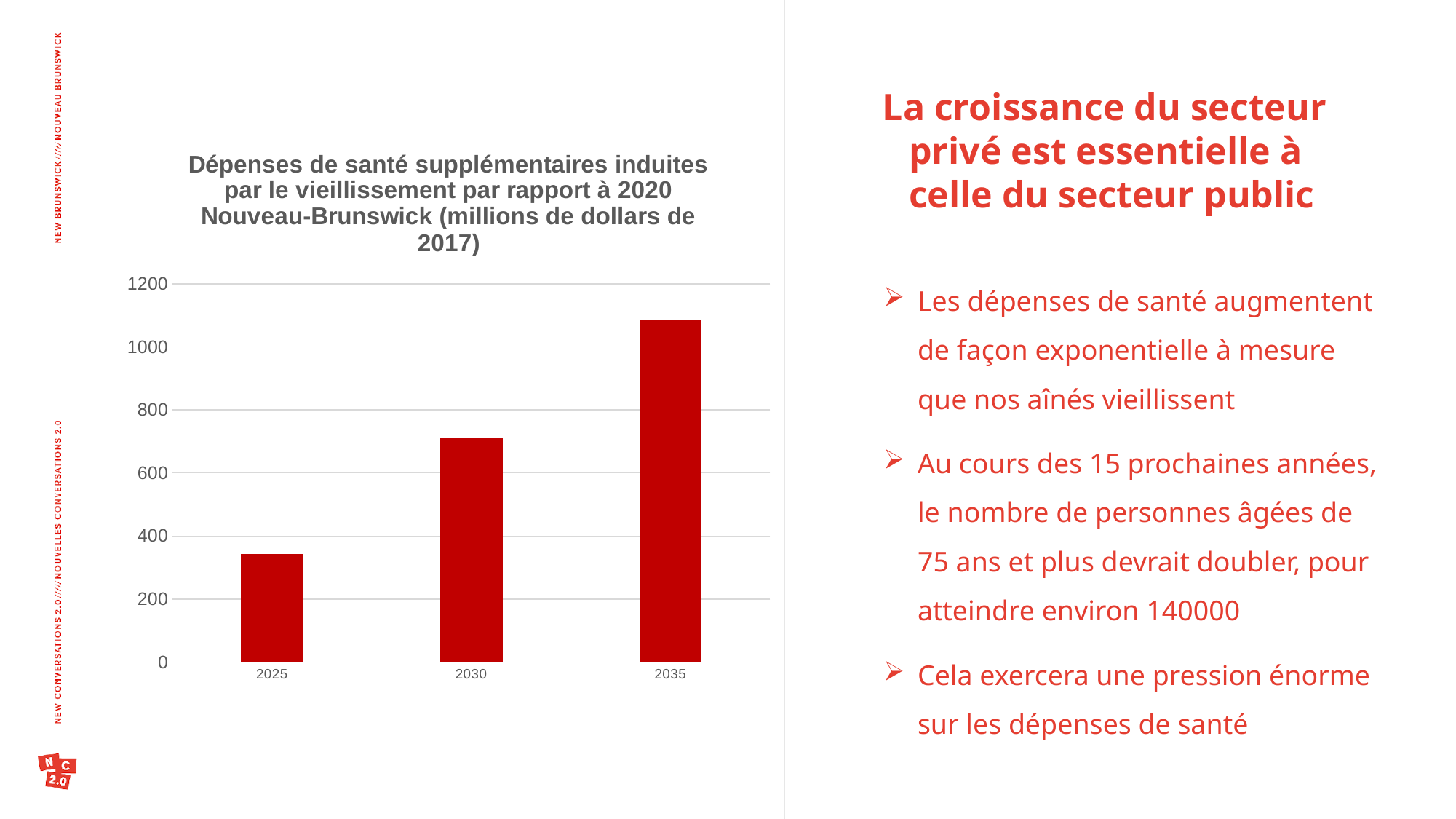
Is the value for 2030 greater or less than 600? greater Which year has the larger value, 2030 or 2035? 2035 Is the value for 2030 greater or less than 800? less Which year has the lowest additional health spending in the chart? 2025 What is the highest value shown on the chart's vertical axis? 1200 Is the value for 2025 greater or less than 400? less Do the values rise or fall from 2025 to 2035? rise Which year has the highest additional health spending in the chart? 2035 What kind of chart is shown on the slide? bar chart Which year has the larger value, 2025 or 2030? 2030 How many years are plotted on the x axis of the chart? 3